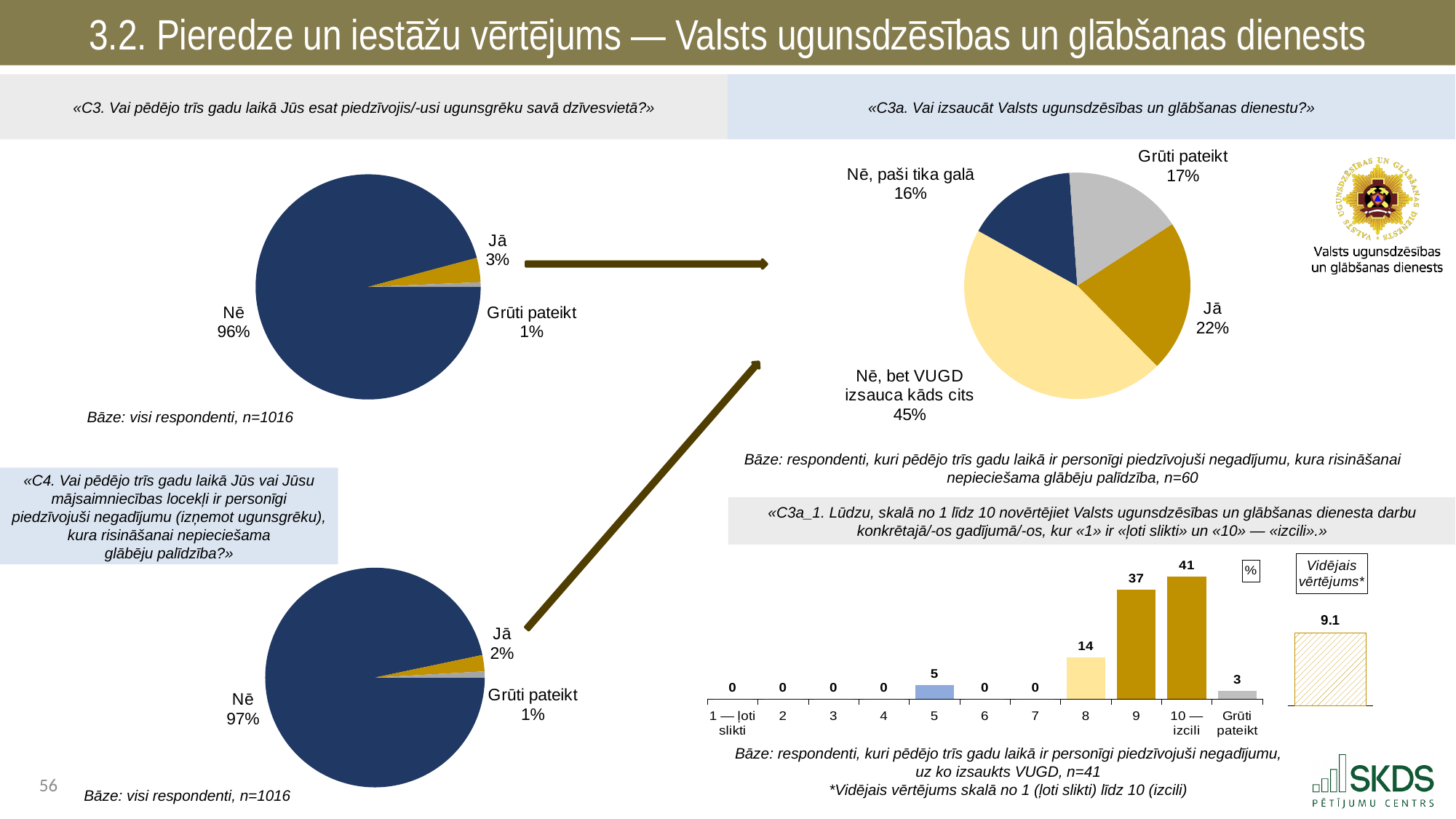
In the C3a_1 bar chart (bottom right), which rating category has the highest value? 10 — izcili In the C4 pie chart (bottom left), what share of respondents answered "Nē"? 97% In the C3a pie chart (top right), what share answered "Nē, bet VUGD izsauca kāds cits"? 45% In the C3a_1 bar chart (bottom right), what is the value for rating 9? 37 In the C3a pie chart (top right), which answer has the smallest share? Nē, paši tika galā In the C3 pie chart (top left), what share of respondents answered "Jā"? 3% In the C3a_1 bar chart (bottom right), what is the difference between the values for rating 10 and rating 8? 27 In the C3a pie chart (top right), what is the difference in percentage points between "Jā" and "Grūti pateikt"? 5 What is the average rating (Vidējais vērtējums) shown next to the C3a_1 bar chart? 9.1 In the C3a pie chart (top right), how many slices does the pie have? 4 In the C4 pie chart (bottom left), which is larger, "Jā" or "Grūti pateikt"? Jā In the C3 pie chart (top left), what share of respondents answered "Nē"? 96%